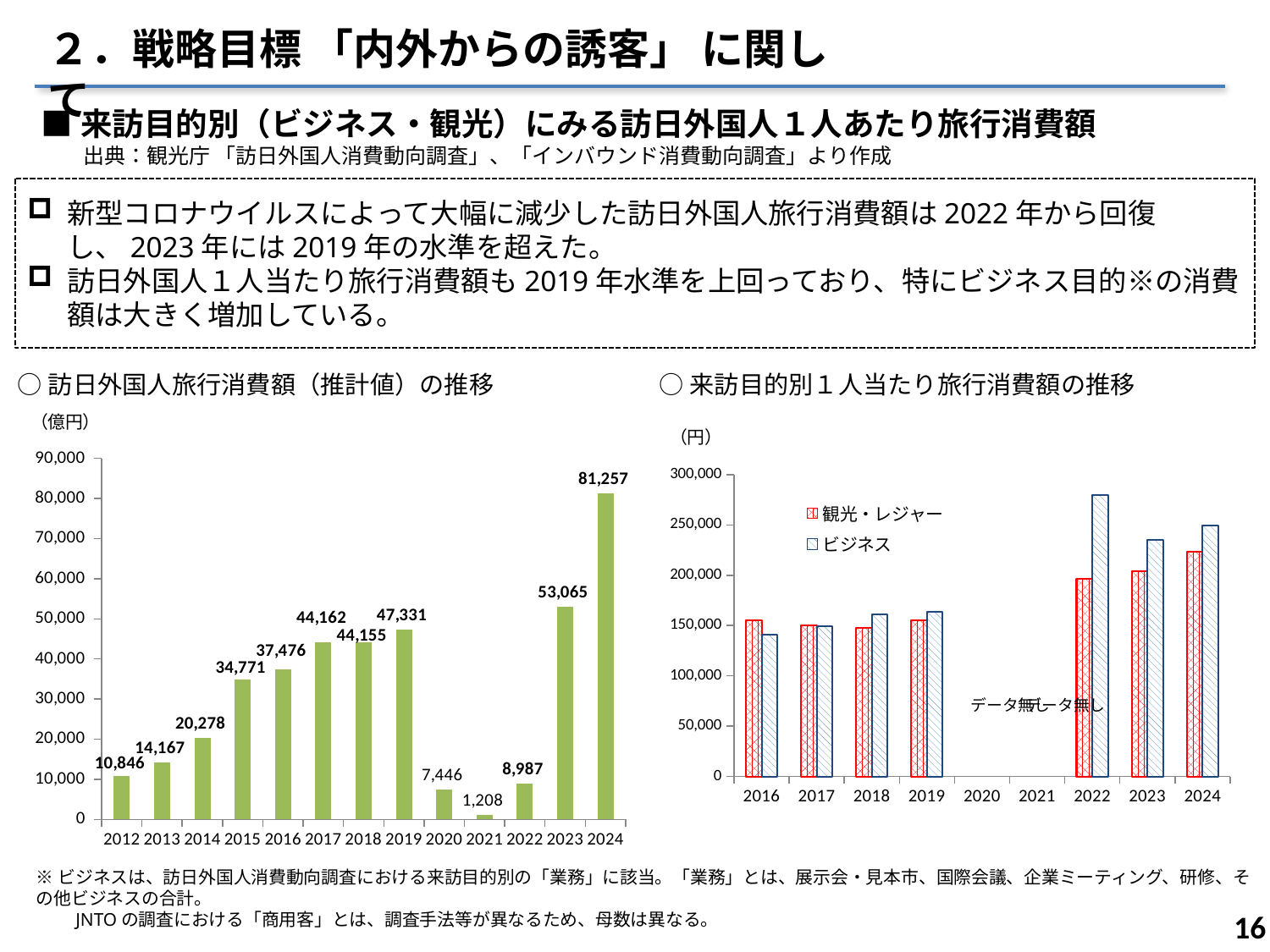
In the right chart (来訪目的別1人当たり旅行消費額の推移), how many series does the legend list? 2 In the left chart (訪日外国人旅行消費額（推計値）の推移), what is the value for 2021? 1,208 In the right chart (来訪目的別1人当たり旅行消費額の推移), which series has the higher value in 2024, 観光・レジャー or ビジネス? ビジネス In the right chart (来訪目的別1人当たり旅行消費額の推移), is the ビジネス value for 2022 greater or less than 250,000? greater What kind of chart is the right chart (来訪目的別1人当たり旅行消費額の推移)? bar chart In the left chart (訪日外国人旅行消費額（推計値）の推移), how many years are shown on the x axis? 13 In the left chart (訪日外国人旅行消費額（推計値）の推移), what is the difference between the 2024 value and the 2023 value? 28,192 In the left chart (訪日外国人旅行消費額（推計値）の推移), which year has the highest value? 2024 In the left chart (訪日外国人旅行消費額（推計値）の推移), is the value for 2020 larger or smaller than the value for 2022? smaller In the left chart (訪日外国人旅行消費額（推計値）の推移), what is the value for 2019? 47,331 In the left chart (訪日外国人旅行消費額（推計値）の推移), which year has the lowest value? 2021 In the left chart (訪日外国人旅行消費額（推計値）の推移), what is the value for 2024? 81,257